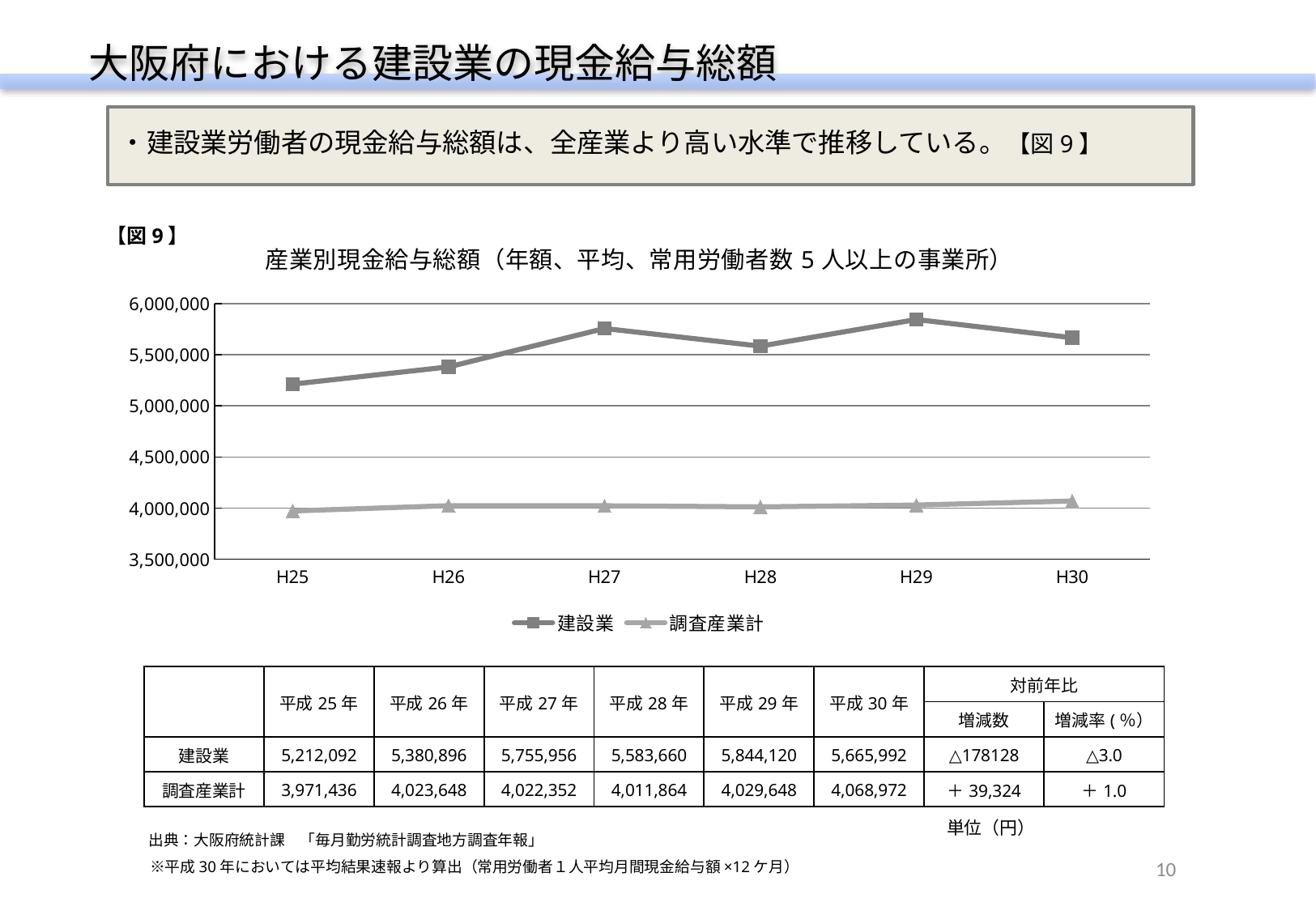
What is the value for 調査産業計 in H30? 4,068,972 In which year is the value for 建設業 lowest? H25 Which series has the larger value in H27, 建設業 or 調査産業計? 建設業 In which year is the value for 建設業 highest? H29 Is the value for 建設業 in H27 greater or less than 5,500,000? greater What is the value for 建設業 in H29? 5,844,120 How many series does the legend of the chart list? 2 What is the title of the chart in 図9? 産業別現金給与総額（年額、平均、常用労働者数5人以上の事業所） Does the value for 建設業 rise or fall from H25 to H27? rise What is the difference between 建設業 and 調査産業計 in H30? 1,597,020 What type of chart is shown in 図9? line chart How many years are plotted along the x axis of the chart? 6